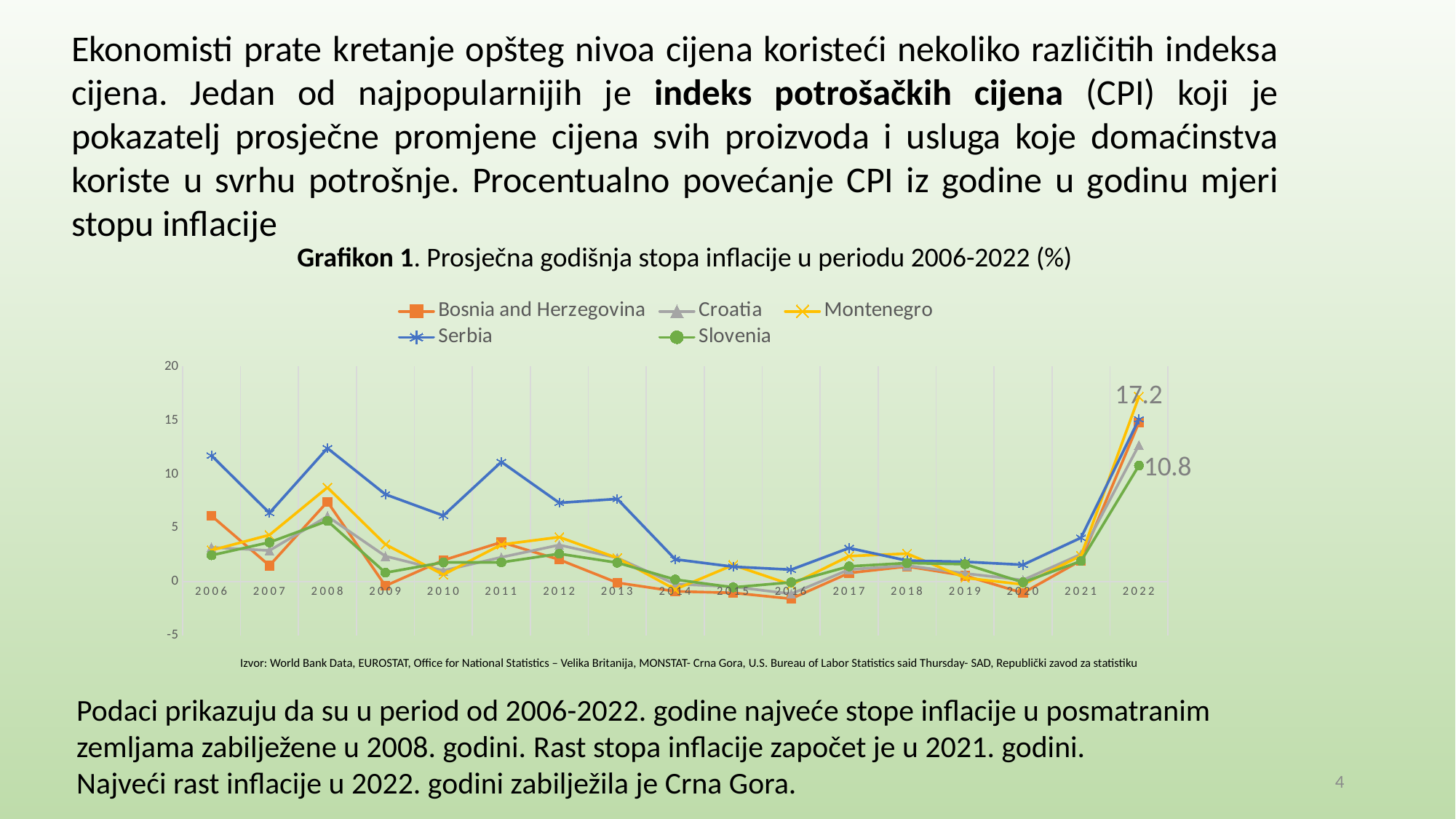
What kind of chart is shown on the slide? line chart What is the value for Slovenia in 2022? 10.8 Which country has the lowest value in 2022? Slovenia Which is larger in 2006, the value for Serbia or the value for Bosnia and Herzegovina? Serbia What is the difference between the 2022 values for Montenegro and Slovenia? 6.4 Do the values for Montenegro rise or fall from 2020 to 2022? rise How many years are shown along the x axis of the chart? 17 Which country has the highest value in 2006? Serbia How many series does the legend of the chart list? 5 What is the value for Montenegro in 2022? 17.2 Which country has the highest value in 2022? Montenegro Is the value for Serbia in 2008 greater or less than 10? greater